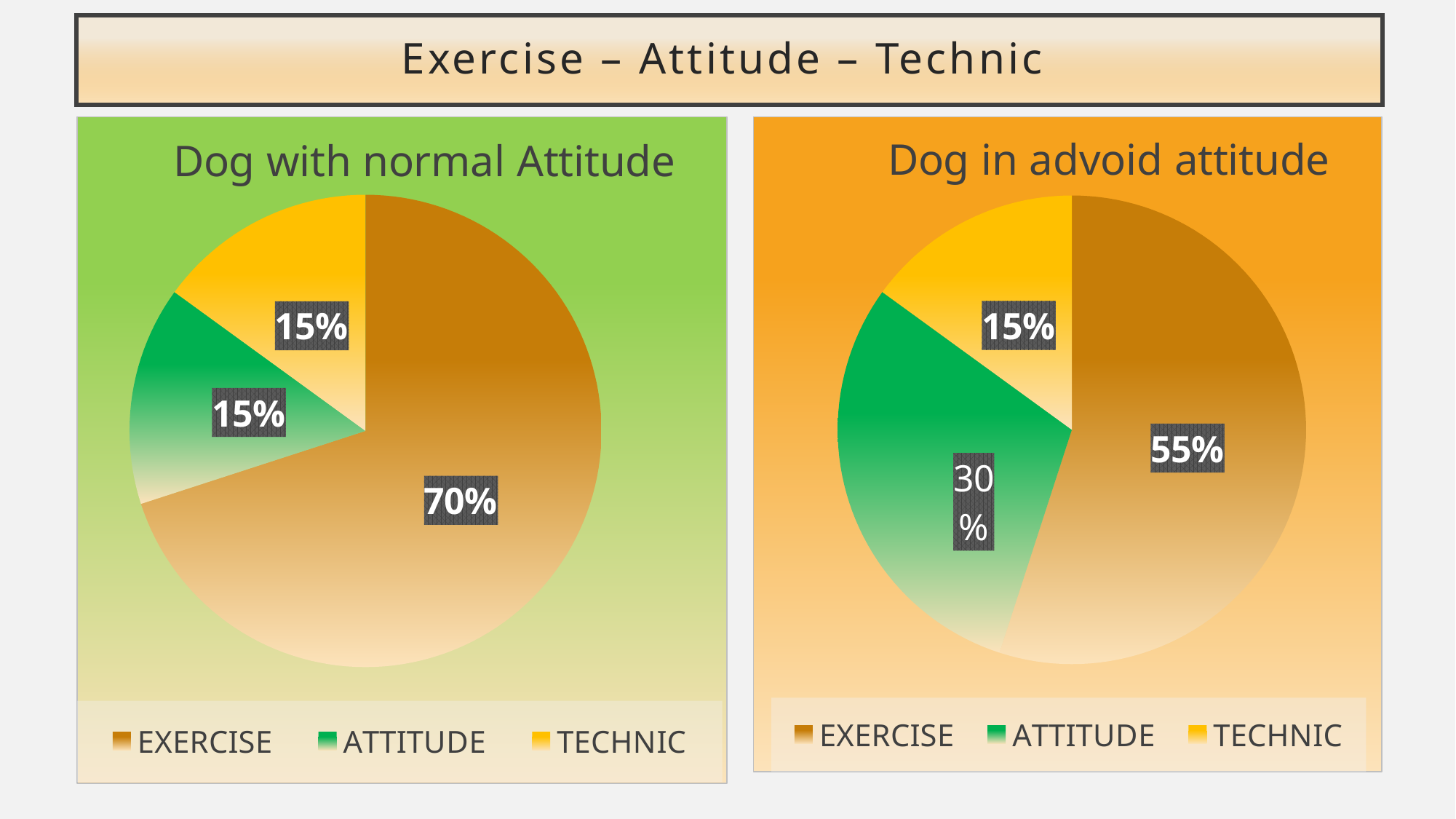
In the 'Dog in advoid attitude' chart, what is the difference between the EXERCISE and ATTITUDE values? 25% In the 'Dog in advoid attitude' chart, what is the value for EXERCISE? 55% In the 'Dog with normal Attitude' chart, which category has the largest slice? EXERCISE In the 'Dog with normal Attitude' chart, what is the value for EXERCISE? 70% In the 'Dog in advoid attitude' chart, which category has the smallest slice? TECHNIC What kind of chart is the 'Dog in advoid attitude' chart? Pie chart In the 'Dog in advoid attitude' chart, which is larger, ATTITUDE or TECHNIC? ATTITUDE In the 'Dog with normal Attitude' chart, what is the value for TECHNIC? 15% In the 'Dog in advoid attitude' chart, what is the value for ATTITUDE? 30% What is the title of the chart on the left side of the slide? Dog with normal Attitude In the 'Dog with normal Attitude' chart, what is the difference between the EXERCISE and ATTITUDE values? 55% How many categories does the 'Dog with normal Attitude' chart show? 3